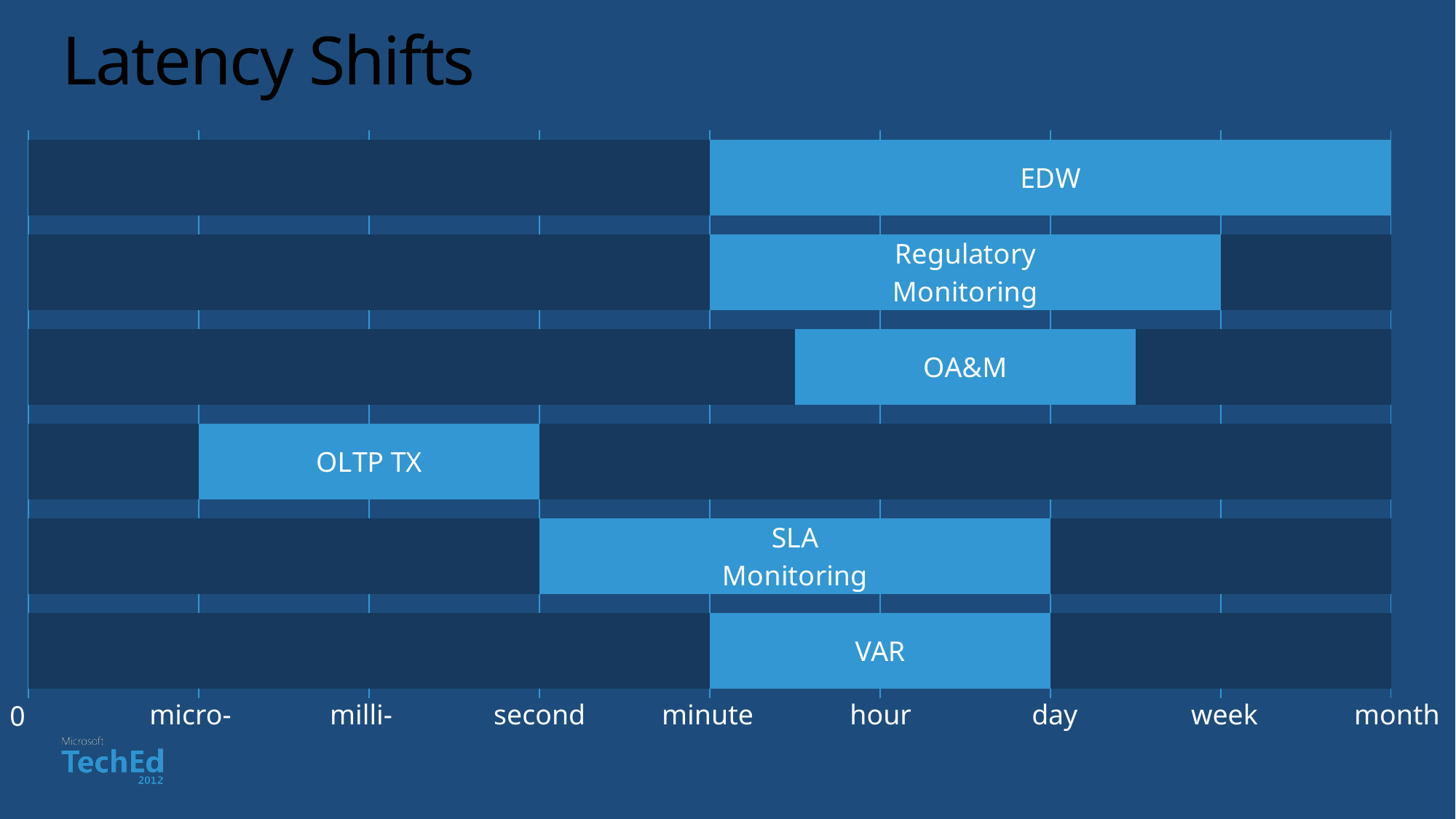
Over which range of x-axis ticks does the SLA Monitoring bar extend? second to day At which x-axis tick does the EDW bar begin? minute Over which range of x-axis ticks does the VAR bar extend? minute to day At which x-axis tick does the EDW bar end? month Which bar spans the widest range on the x axis? EDW What is the title of the chart? Latency Shifts Which bar starts furthest to the left on the x axis? OLTP TX At which x-axis tick does the OLTP TX bar begin? micro- At which x-axis tick does the Regulatory Monitoring bar end? week How many labelled bars does the chart contain? 6 At which x-axis tick does the OLTP TX bar end? second What kind of chart is shown on the slide? bar chart